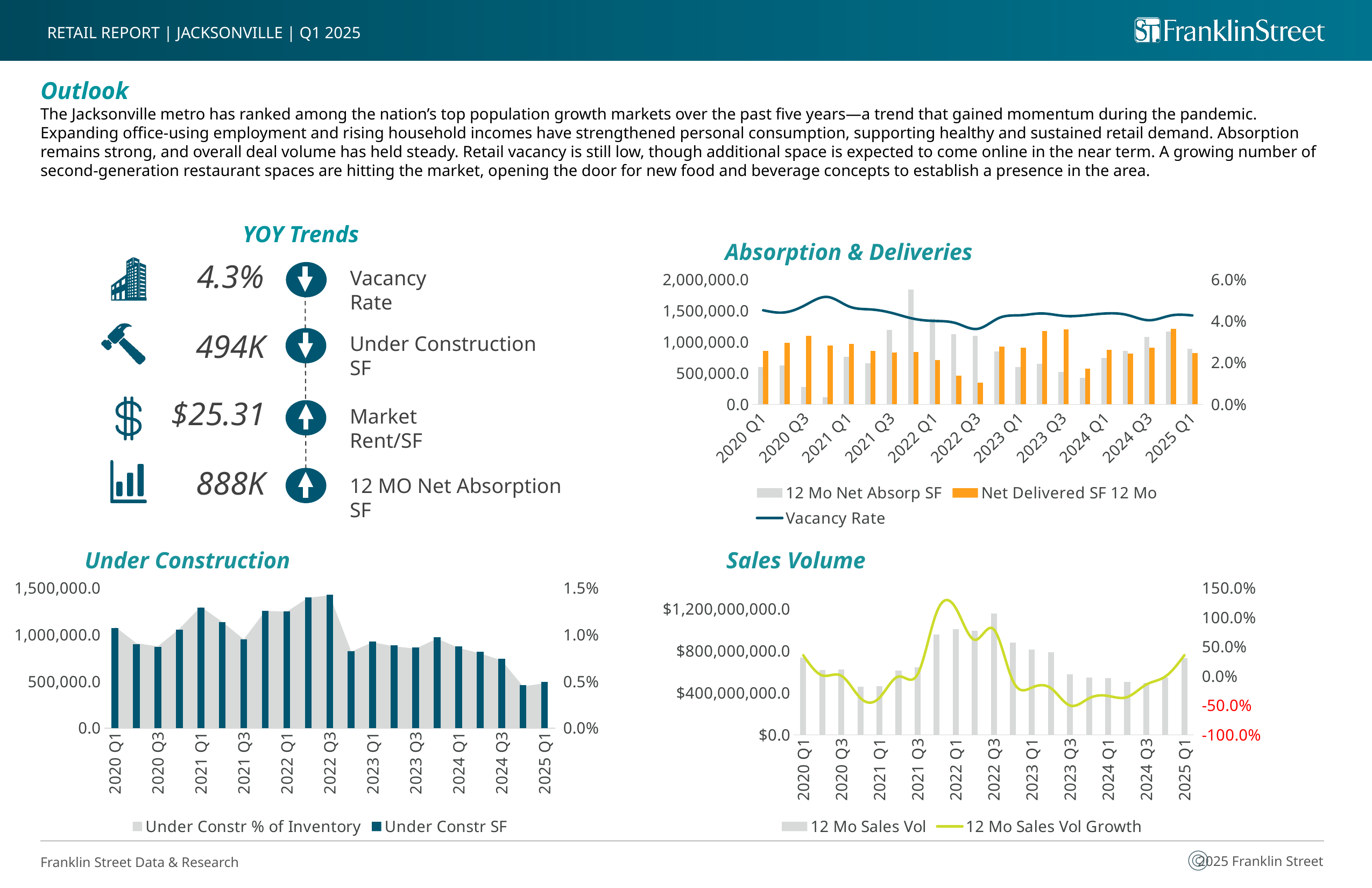
In the Absorption & Deliveries chart, how many series does the legend list? 3 In the Under Construction chart, how many series does the legend list? 2 In the Under Construction chart, which is larger, the Under Constr SF value for 2020 Q1 or for 2025 Q1? 2020 Q1 In the Absorption & Deliveries chart, is the 12 Mo Net Absorp SF value for 2022 Q1 greater or less than 1,500,000.0? less In the Under Construction chart, is the Under Constr SF value for 2025 Q1 greater or less than 1,000,000.0? less In the Under Construction chart, do the Under Constr SF bars rise or fall from 2022 Q3 to 2025 Q1? fall In the Absorption & Deliveries chart, is the Net Delivered SF 12 Mo value for 2022 Q3 greater or less than 500,000.0? less In the Absorption & Deliveries chart, which series is drawn as a line rather than bars? Vacancy Rate In the Sales Volume chart, which quarter has the highest 12 Mo Sales Vol bar? 2022 Q3 In the Absorption & Deliveries chart, which quarter has the highest 12 Mo Net Absorp SF bar? 2021 Q4